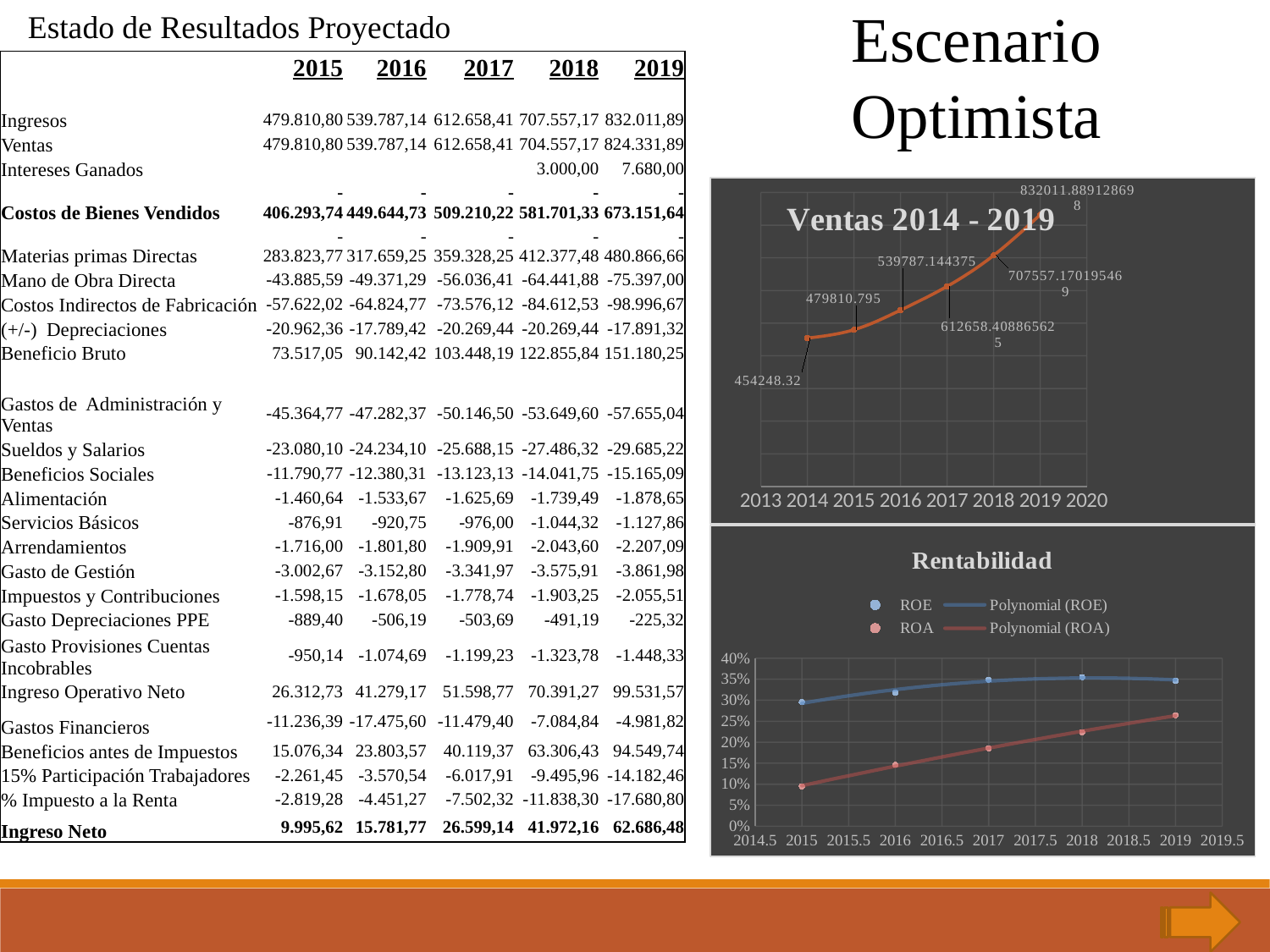
In the 'Rentabilidad' chart, which is larger in 2019, ROE or ROA? ROE In the 'Ventas 2014 - 2019' chart, what is the value labelled for 2016? 539787.144375 In the 'Ventas 2014 - 2019' chart, how many data points are plotted? 6 In the 'Rentabilidad' chart, how many entries does the legend list? 4 In the 'Ventas 2014 - 2019' chart, what is the difference between the 2015 value and the 2014 value? 25562.475 In the 'Ventas 2014 - 2019' chart, do the values rise or fall from 2014 to 2019? rise In the 'Ventas 2014 - 2019' chart, what is the value labelled for 2014? 454248.32 In the 'Ventas 2014 - 2019' chart, what is the value labelled for 2015? 479810.795 In the 'Rentabilidad' chart, is the ROA value for 2019 greater or less than 25%? greater In the 'Ventas 2014 - 2019' chart, which year has the lowest value? 2014 In the 'Ventas 2014 - 2019' chart, which year has the highest value? 2019